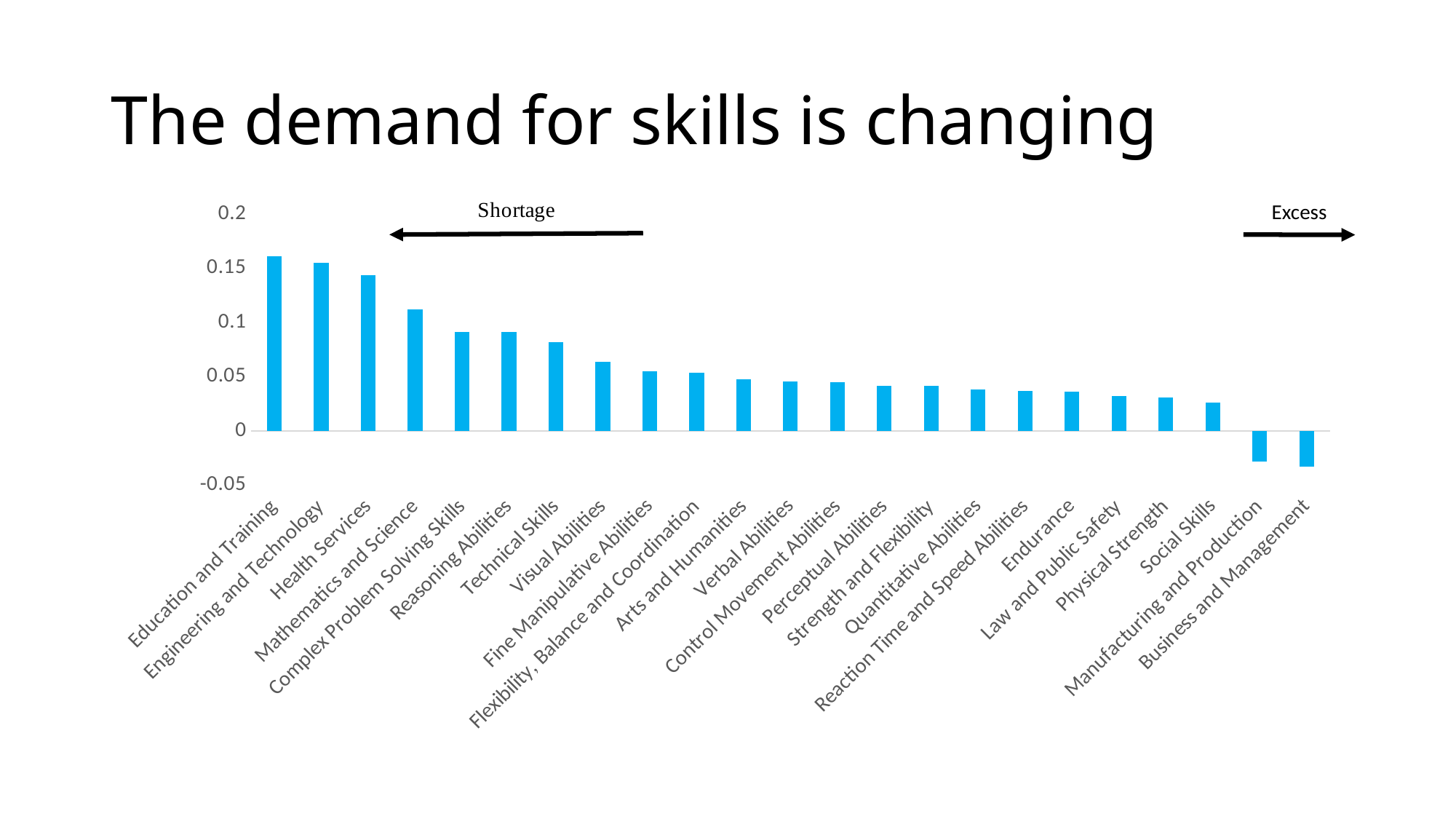
Is the value for Mathematics and Science greater or less than 0.1? greater Is the value for Social Skills greater or less than 0.05? less Is the value for Health Services greater or less than 0.15? less What kind of chart is shown on the slide? bar chart Which is larger, the value for Engineering and Technology or the value for Verbal Abilities? Engineering and Technology How many categories (bars) are plotted in the chart? 23 Do the bar values generally rise or fall moving from left to right along the x axis? fall What label is shown above the arrow pointing to the right at the top right of the chart? Excess Which category has the highest value in the chart? Education and Training